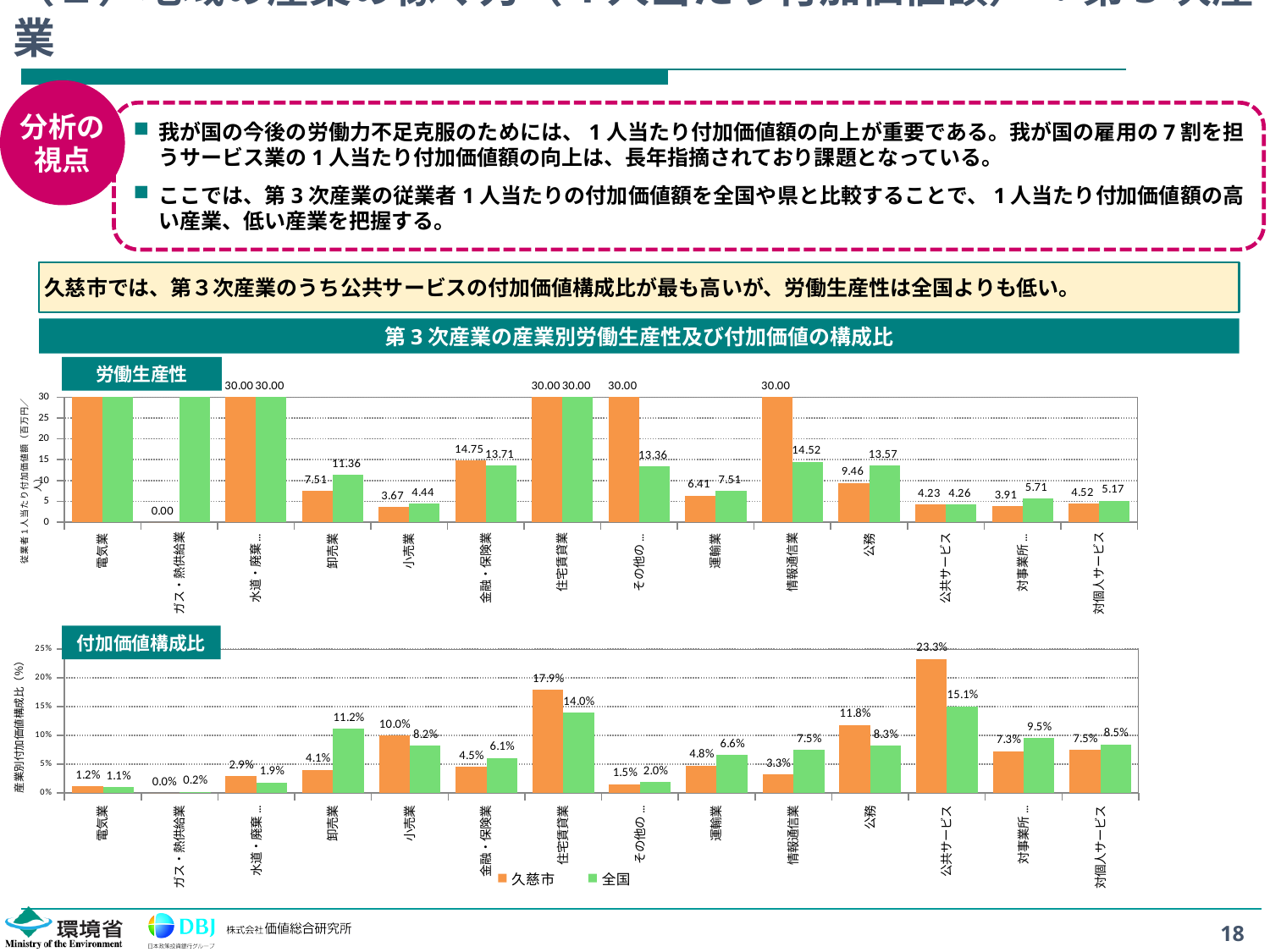
In the 付加価値構成比 chart, which category has the highest value for 久慈市? 公共サービス In the 労働生産性 chart, what is the difference between 全国 and 久慈市 in 卸売業? 3.85 What kind of chart is the 労働生産性 chart? bar chart In the 付加価値構成比 chart, which is larger in 運輸業, 久慈市 or 全国? 全国 In the 付加価値構成比 chart, what is the value for 久慈市 in 公共サービス? 23.3% In the 付加価値構成比 chart, which category has the lowest value for 全国? ガス・熱供給業 In the 労働生産性 chart, which is larger in 情報通信業, 久慈市 or 全国? 久慈市 In the 付加価値構成比 chart, what is the value for 全国 in 卸売業? 11.2% In the 労働生産性 chart, what is the value for 全国 in 公務? 13.57 In the 労働生産性 chart, what is the value for 久慈市 in 金融・保険業? 14.75 In the 付加価値構成比 chart, what is the difference between 久慈市 and 全国 in 住宅賃貸業? 3.9% How many series does the legend list? 2